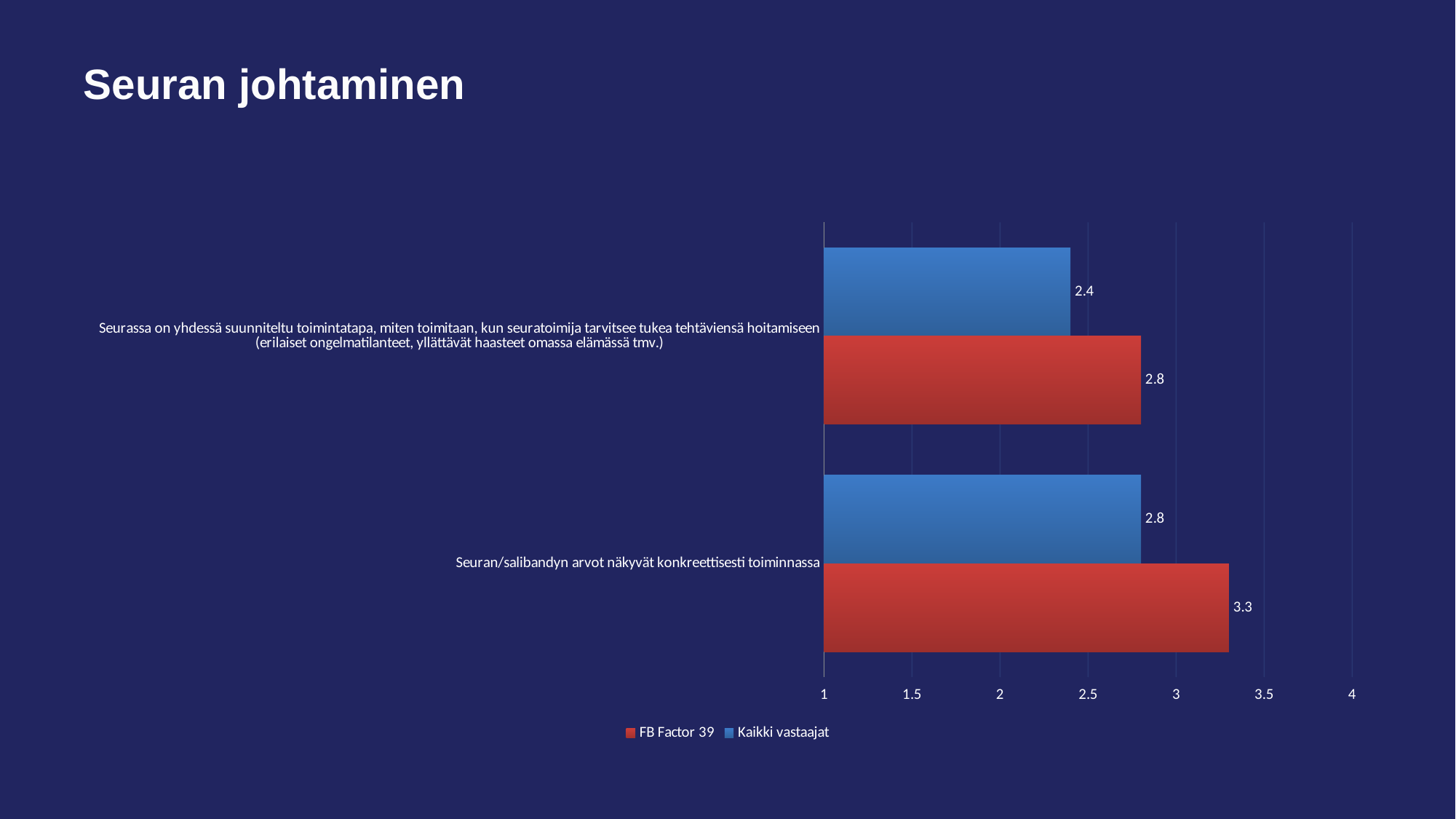
What is the difference between the FB Factor 39 and Kaikki vastaajat values for "Seuran/salibandyn arvot näkyvät konkreettisesti toiminnassa"? 0.5 What is the value for Kaikki vastaajat for the category "Seurassa on yhdessä suunniteltu toimintatapa..."? 2.4 How many categories are shown in the chart? 2 What is the value for FB Factor 39 for the category about a jointly planned procedure for supporting club actors ("Seurassa on yhdessä suunniteltu toimintatapa...")? 2.8 What is the value for Kaikki vastaajat for "Seuran/salibandyn arvot näkyvät konkreettisesti toiminnassa"? 2.8 How many series does the legend list? 2 What is the difference between the FB Factor 39 and Kaikki vastaajat values for "Seurassa on yhdessä suunniteltu toimintatapa..."? 0.4 Which category has the highest FB Factor 39 value? Seuran/salibandyn arvot näkyvät konkreettisesti toiminnassa What kind of chart is shown on the slide? Bar chart Which category has the lowest Kaikki vastaajat value? Seurassa on yhdessä suunniteltu toimintatapa, miten toimitaan, kun seuratoimija tarvitsee tukea tehtäviensä hoitamiseen For "Seuran/salibandyn arvot näkyvät konkreettisesti toiminnassa", which series has the larger value, FB Factor 39 or Kaikki vastaajat? FB Factor 39 What is the value for FB Factor 39 for "Seuran/salibandyn arvot näkyvät konkreettisesti toiminnassa"? 3.3